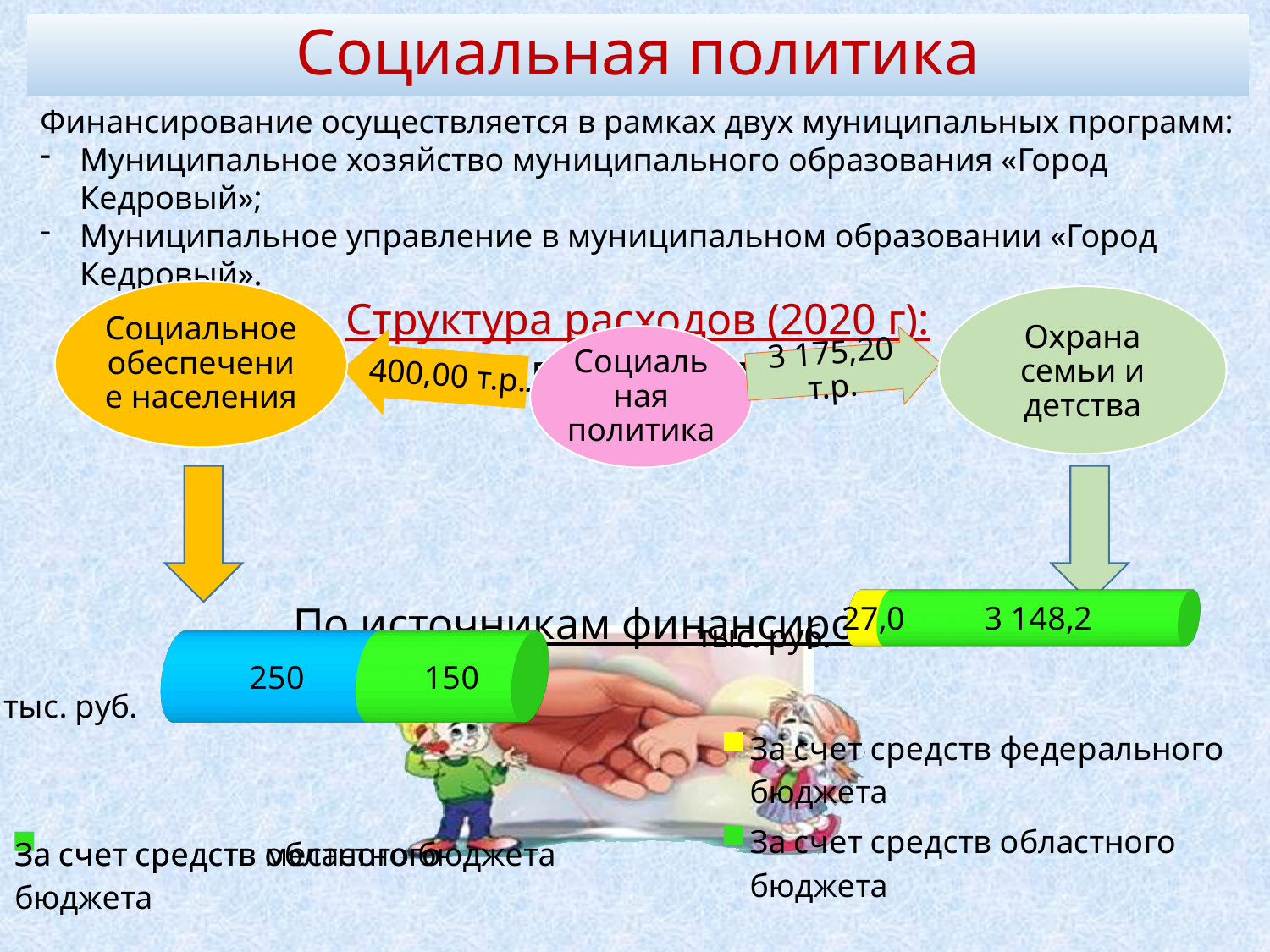
In the left bar chart (under 'Социальное обеспечение населения'), what is the total of the two segments? 400 In the right bar chart (under 'Охрана семьи и детства'), what is the value for 'За счет средств федерального бюджета'? 27,0 In the left bar chart (under 'Социальное обеспечение населения'), what is the value of the blue segment? 250 In the right bar chart (under 'Охрана семьи и детства'), what is the value for 'За счет средств областного бюджета'? 3 148,2 In the left bar chart (under 'Социальное обеспечение населения'), what is the value of the green segment? 150 In the left bar chart (under 'Социальное обеспечение населения'), which segment is larger, the blue one or the green one? the blue one (250) In the right bar chart (under 'Охрана семьи и детства'), what is the total of the two segments? 3 175,2 In the right bar chart (under 'Охрана семьи и детства'), which funding source has the larger value? За счет средств областного бюджета In the right bar chart (under 'Охрана семьи и детства'), which funding source has the smaller value? За счет средств федерального бюджета How many entries does the legend of the right bar chart (under 'Охрана семьи и детства') list? 2 What kind of chart is used to show the funding sources on the slide? stacked bar chart In the left bar chart (under 'Социальное обеспечение населения'), what is the difference between the blue segment and the green segment? 100